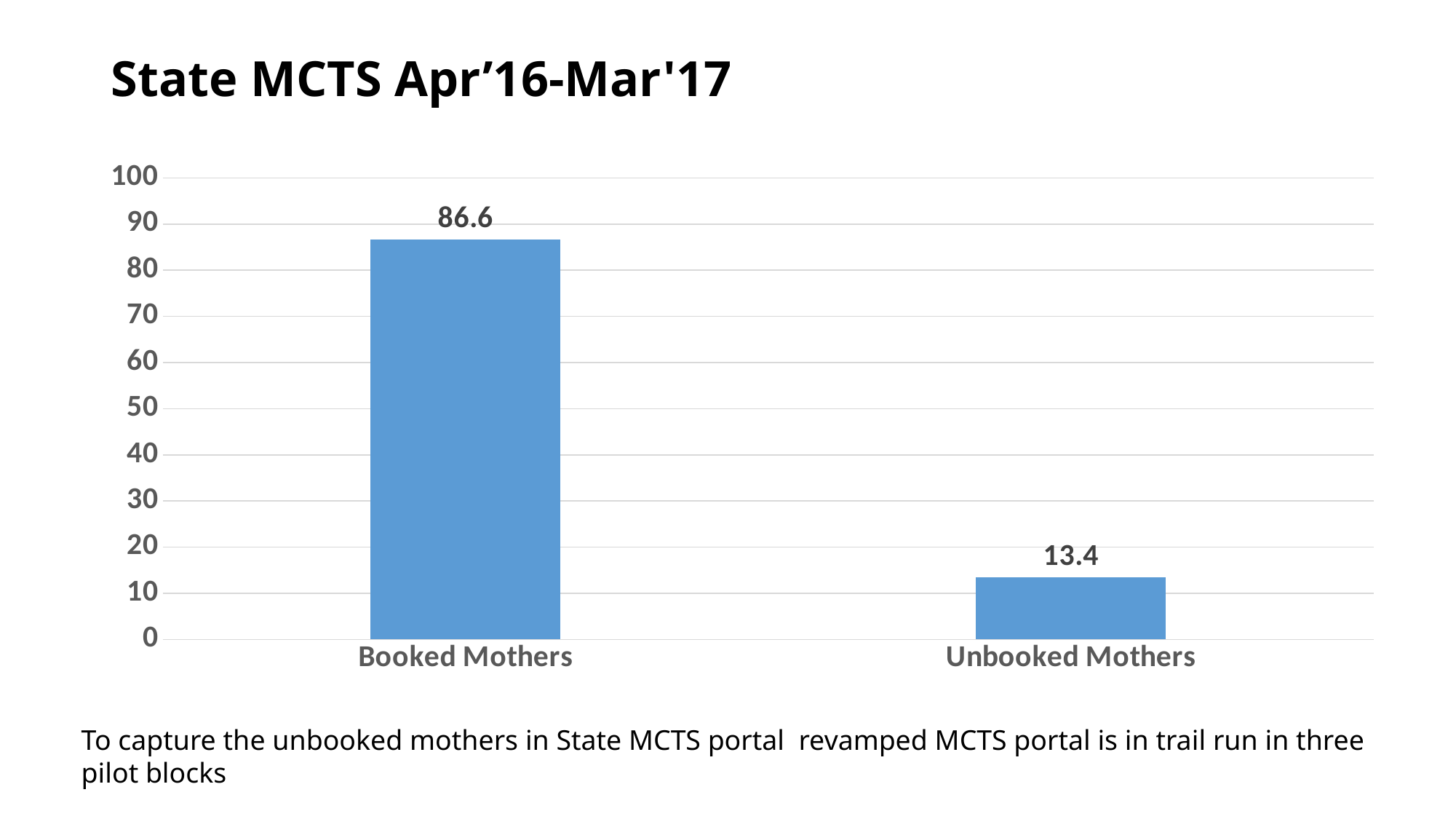
What is the value for Booked Mothers? 86.6 What is the title of the chart? State MCTS Apr'16-Mar'17 Which is larger, the value for Booked Mothers or the value for Unbooked Mothers? Booked Mothers What is the difference between the values for Booked Mothers and Unbooked Mothers? 73.2 What kind of chart is shown on the slide? bar chart Is the value for Unbooked Mothers greater or less than 20? less Which category has the lowest value? Unbooked Mothers Which category has the highest value? Booked Mothers What is the highest value shown on the vertical axis? 100 Is the value for Booked Mothers greater or less than 80? greater What is the value for Unbooked Mothers? 13.4 How many categories are shown in the chart? 2